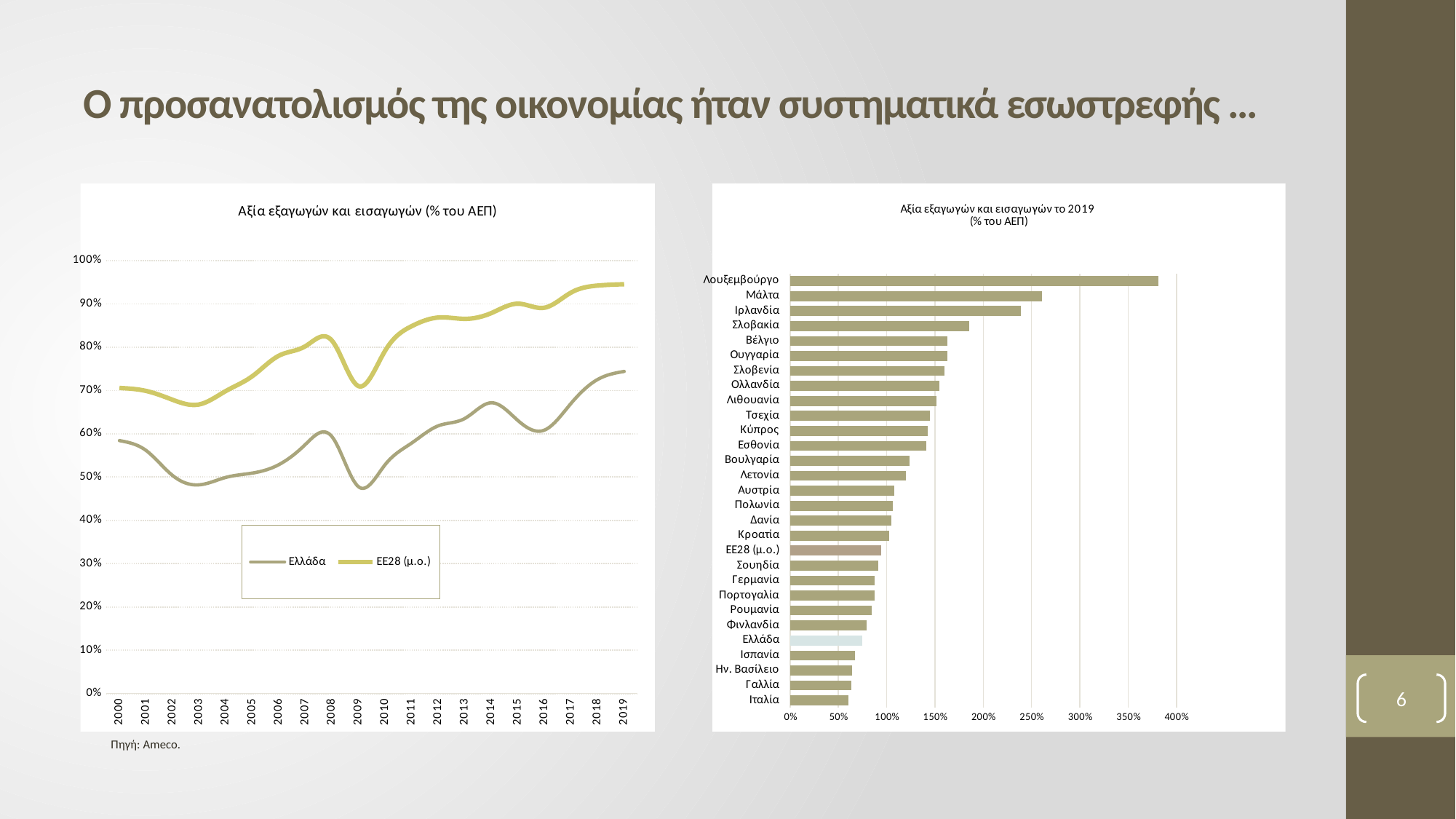
In the left line chart, how many series does the legend list? 2 In the left line chart, how many years are shown on the x axis? 20 In the right bar chart, which category has the lowest value? Ιταλία What kind of chart is the left chart titled 'Αξία εξαγωγών και εισαγωγών (% του ΑΕΠ)'? line chart In the right bar chart, is the value for Ελλάδα greater or less than 100%? less In the left line chart, what are the two series named in the legend? Ελλάδα and ΕΕ28 (μ.ο.) What kind of chart is the right chart titled 'Αξία εξαγωγών και εισαγωγών το 2019 (% του ΑΕΠ)'? bar chart In the left line chart, does the Ελλάδα series rise or fall from 2016 to 2019? rise In the left line chart, which series has the higher value in 2019, Ελλάδα or ΕΕ28 (μ.ο.)? ΕΕ28 (μ.ο.) In the right bar chart, which country has the highest value? Λουξεμβούργο In the right bar chart, how many bars are shown? 29 In the left line chart, is the value for Ελλάδα in 2009 greater or less than 50%? less